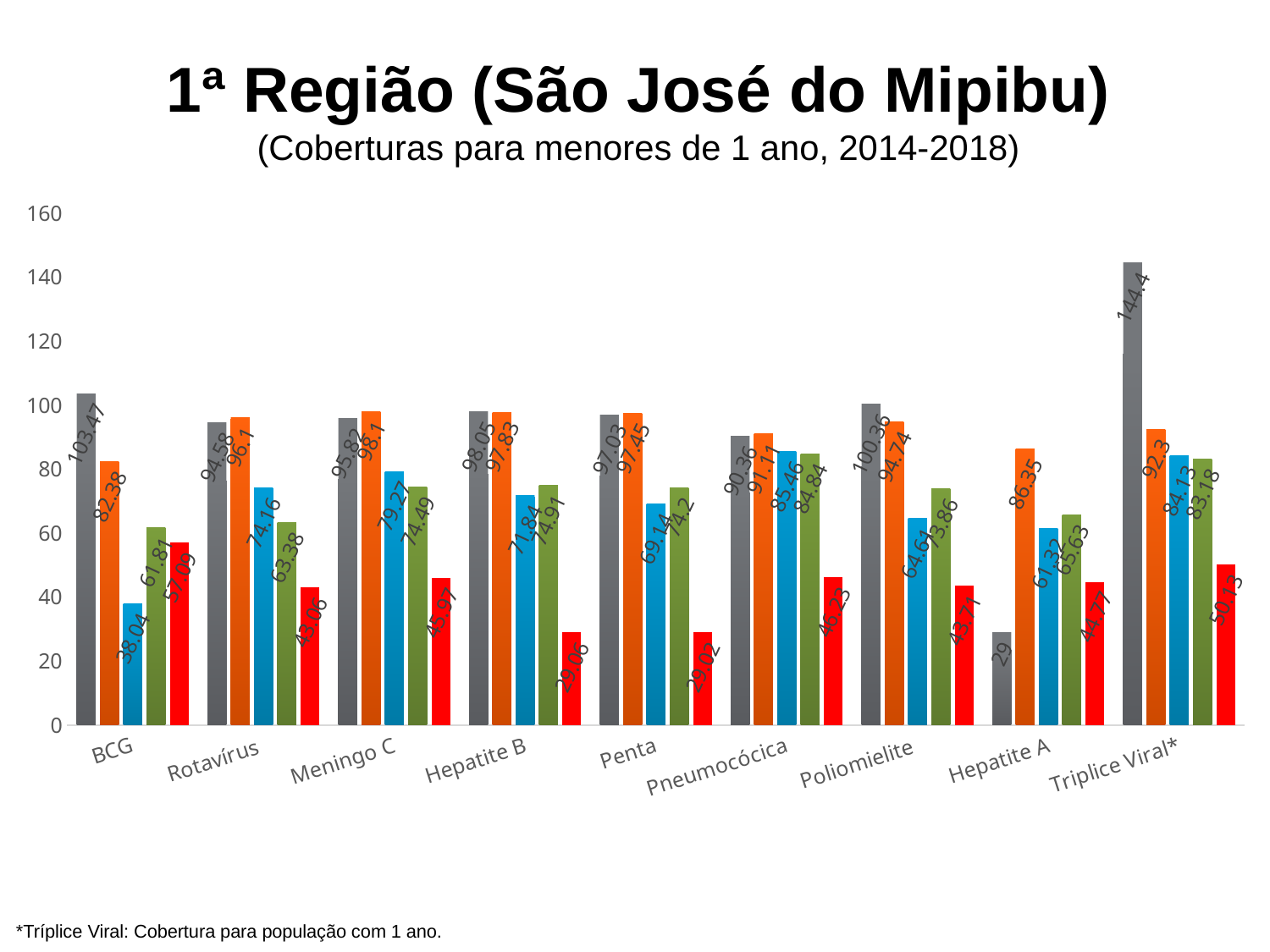
What is the main title of the chart slide? 1ª Região (São José do Mipibu) What is the difference between the gray bar and the orange bar for BCG? 21.09 What is the value of the blue bar for Pneumocócica? 85.46 What is the value of the orange bar for Hepatite A? 86.35 What is the value of the gray bar for BCG? 103.47 What type of chart is shown on the slide? bar chart How many bars are plotted for each vaccine category? 5 For Hepatite A, which is larger: the gray bar or the orange bar? the orange bar Which vaccine category has the tallest bar in the chart? Tríplice Viral* What is the value of the red bar for Hepatite B? 29.06 How many vaccine categories are shown on the x axis? 9 Is the value of the gray bar for Tríplice Viral* greater or less than 140? greater